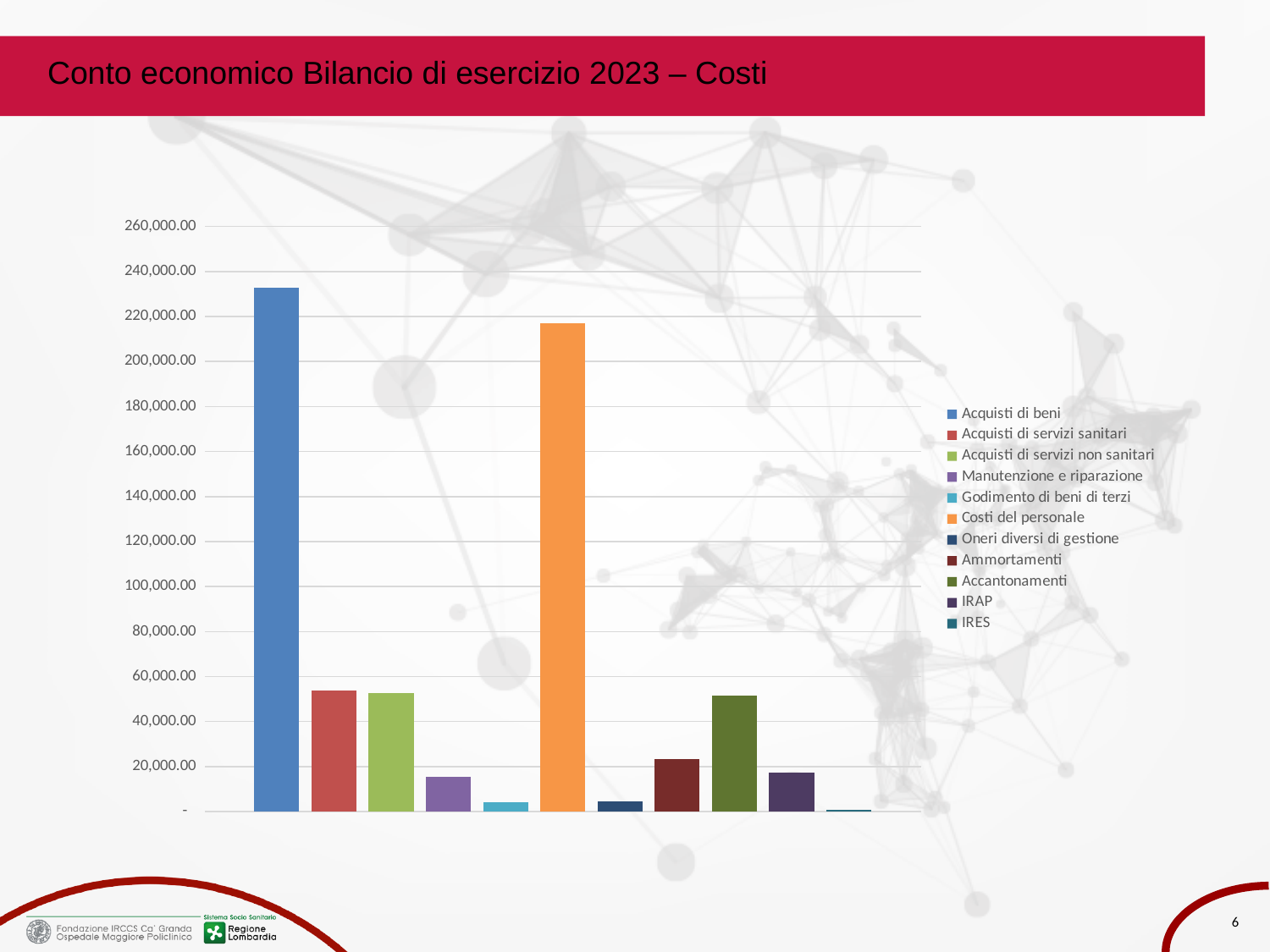
Is the value for Manutenzione e riparazione greater or less than 20,000.00? less What kind of chart is shown on the slide? bar chart How many series does the legend list? 11 Which is larger, Acquisti di beni or Costi del personale? Acquisti di beni Which cost category has the highest bar? Acquisti di beni What is the title of the slide containing the chart? Conto economico Bilancio di esercizio 2023 – Costi Is the value for Costi del personale greater or less than 200,000.00? greater Which is larger, Ammortamenti or Godimento di beni di terzi? Ammortamenti Is the value for Acquisti di beni greater or less than 220,000.00? greater Which cost category has the lowest bar? IRES